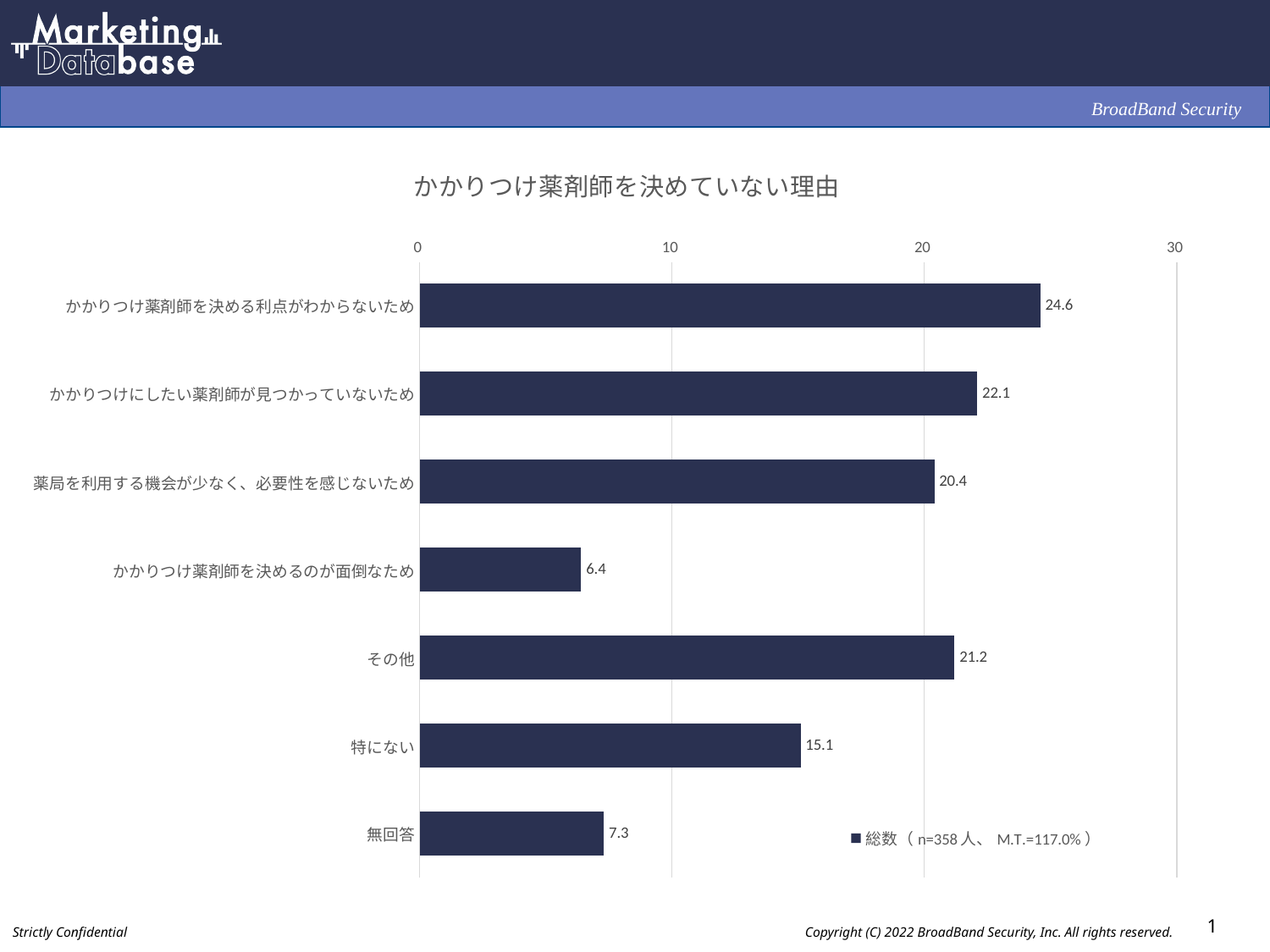
What kind of chart is shown on the slide? Bar chart What is the value for 特にない? 15.1 How many series does the legend list? 1 Is the value for 薬局を利用する機会が少なく、必要性を感じないため greater or less than 20? greater What is the difference between the values for かかりつけにしたい薬剤師が見つかっていないため and 薬局を利用する機会が少なく、必要性を感じないため? 1.7 What is the value for かかりつけ薬剤師を決める利点がわからないため? 24.6 How many categories are shown in the chart? 7 What is the value for 無回答? 7.3 Which is larger, the value for その他 or the value for 特にない? その他 Which category has the lowest value? かかりつけ薬剤師を決めるのが面倒なため What is the title of the chart? かかりつけ薬剤師を決めていない理由 Which category has the highest value? かかりつけ薬剤師を決める利点がわからないため